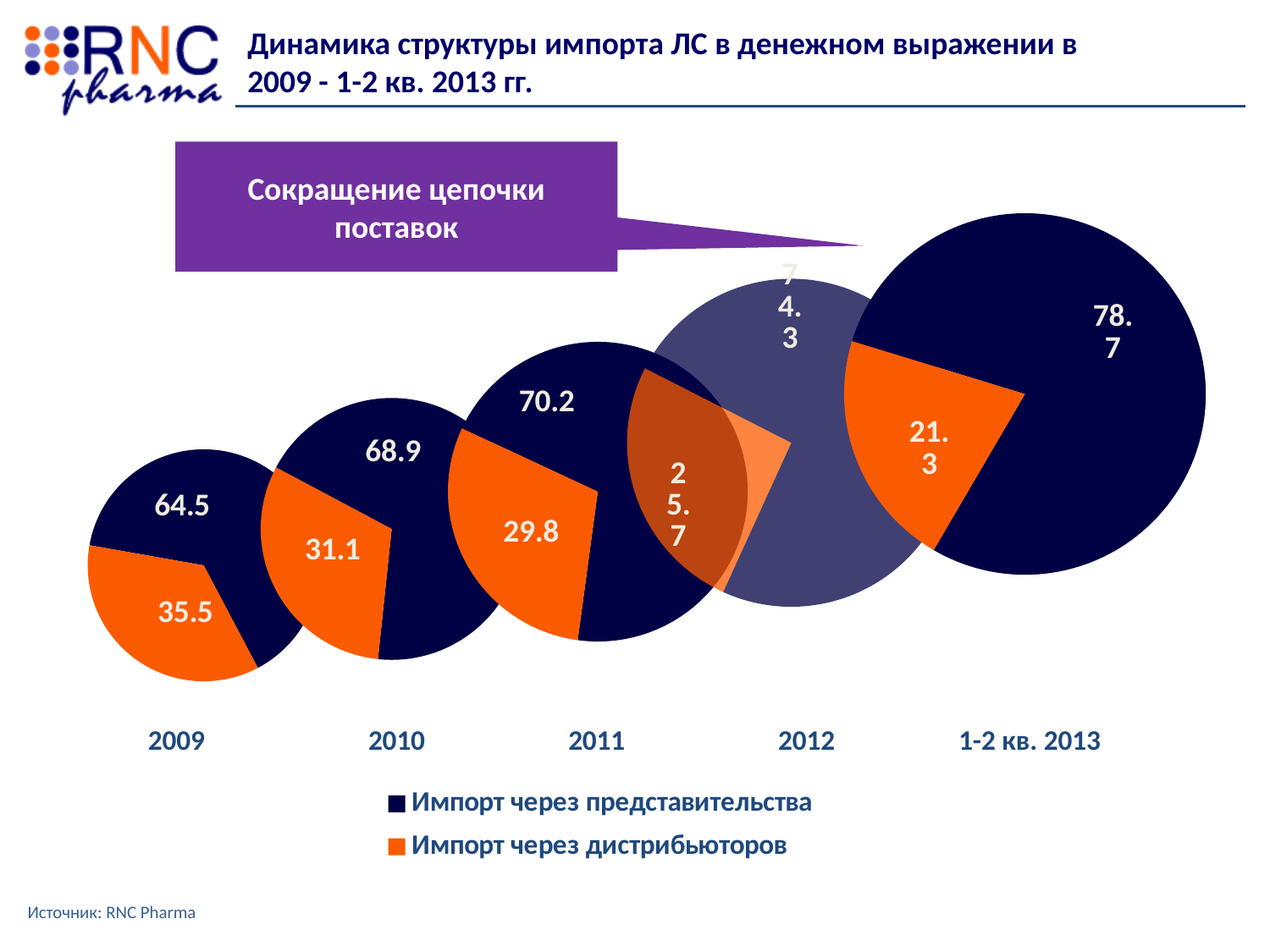
Which is larger: Импорт через дистрибьюторов in the 2010 pie chart or in the 2011 pie chart? 2010 How many pie charts are shown on the slide? 5 In the 2009 pie chart, what is the value for Импорт через представительства? 64.5 Across the pie charts, in which period is the value for Импорт через дистрибьюторов the highest? 2009 In the 1-2 кв. 2013 pie chart, what is the value for Импорт через представительства? 78.7 What is the difference between the Импорт через представительства values in the 1-2 кв. 2013 and 2009 pie charts? 14.2 How many series does the legend list? 2 In the 2010 pie chart, what is the value for Импорт через дистрибьюторов? 31.1 In the 1-2 кв. 2013 pie chart, what is the value for Импорт через дистрибьюторов? 21.3 In the 2009 pie chart, what is the value for Импорт через дистрибьюторов? 35.5 In the 2011 pie chart, what is the value for Импорт через представительства? 70.2 Across the pie charts, in which period is the value for Импорт через представительства the lowest? 2009